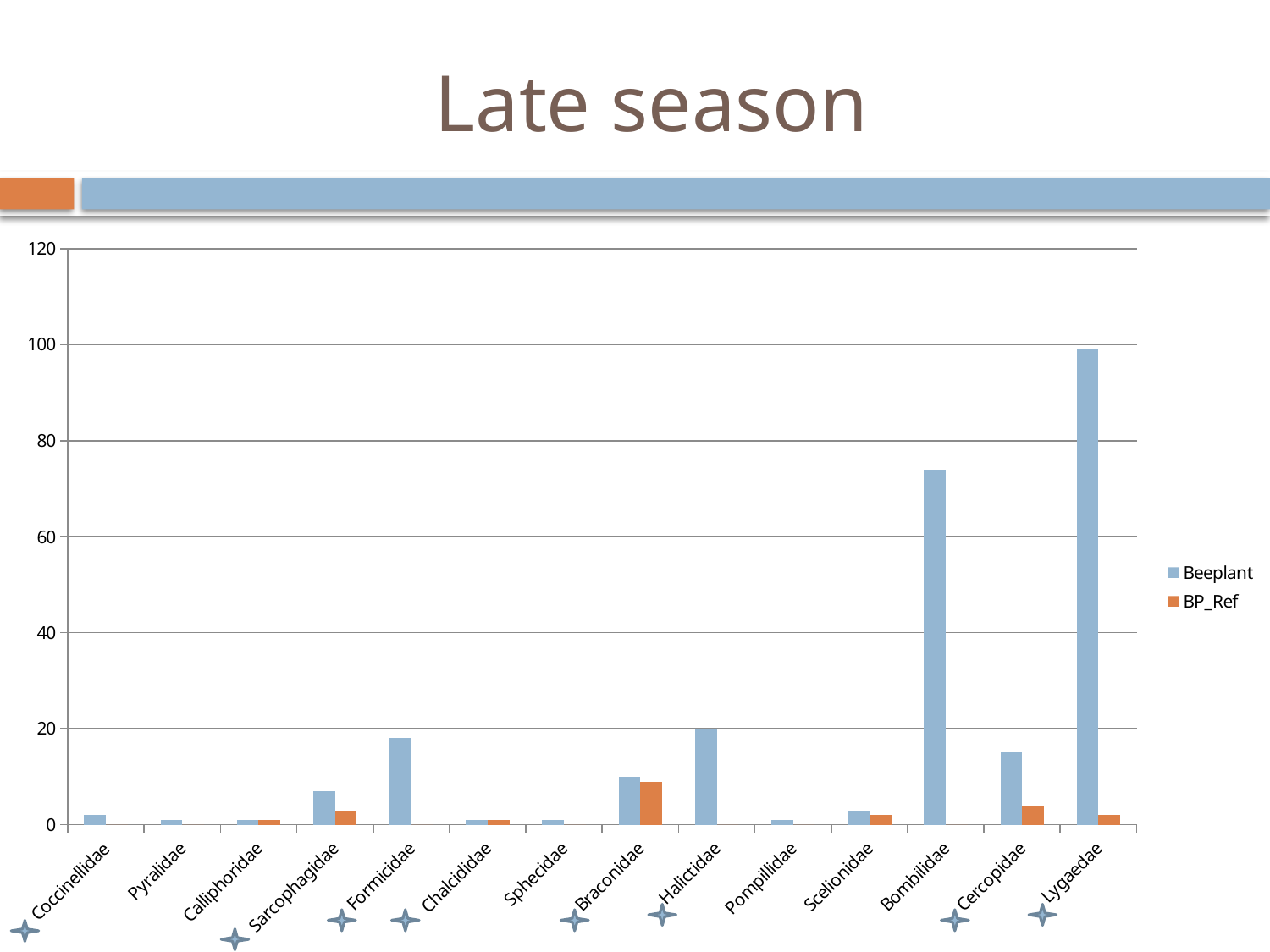
Is the Beeplant value for Bombilidae greater or less than 80? less Is the Beeplant value for Bombilidae greater or less than 60? greater How many categories are shown along the x axis? 14 Is the Beeplant value for Lygaedae greater or less than 80? greater What are the two series named in the legend? Beeplant and BP_Ref Which is larger, the Beeplant value for Cercopidae or the BP_Ref value for Cercopidae? Beeplant Which category has the highest Beeplant value? Lygaedae What is the title of the slide? Late season What kind of chart is shown on the slide? bar chart Which is larger, the Beeplant value for Bombilidae or the Beeplant value for Lygaedae? Lygaedae How many series does the legend list? 2